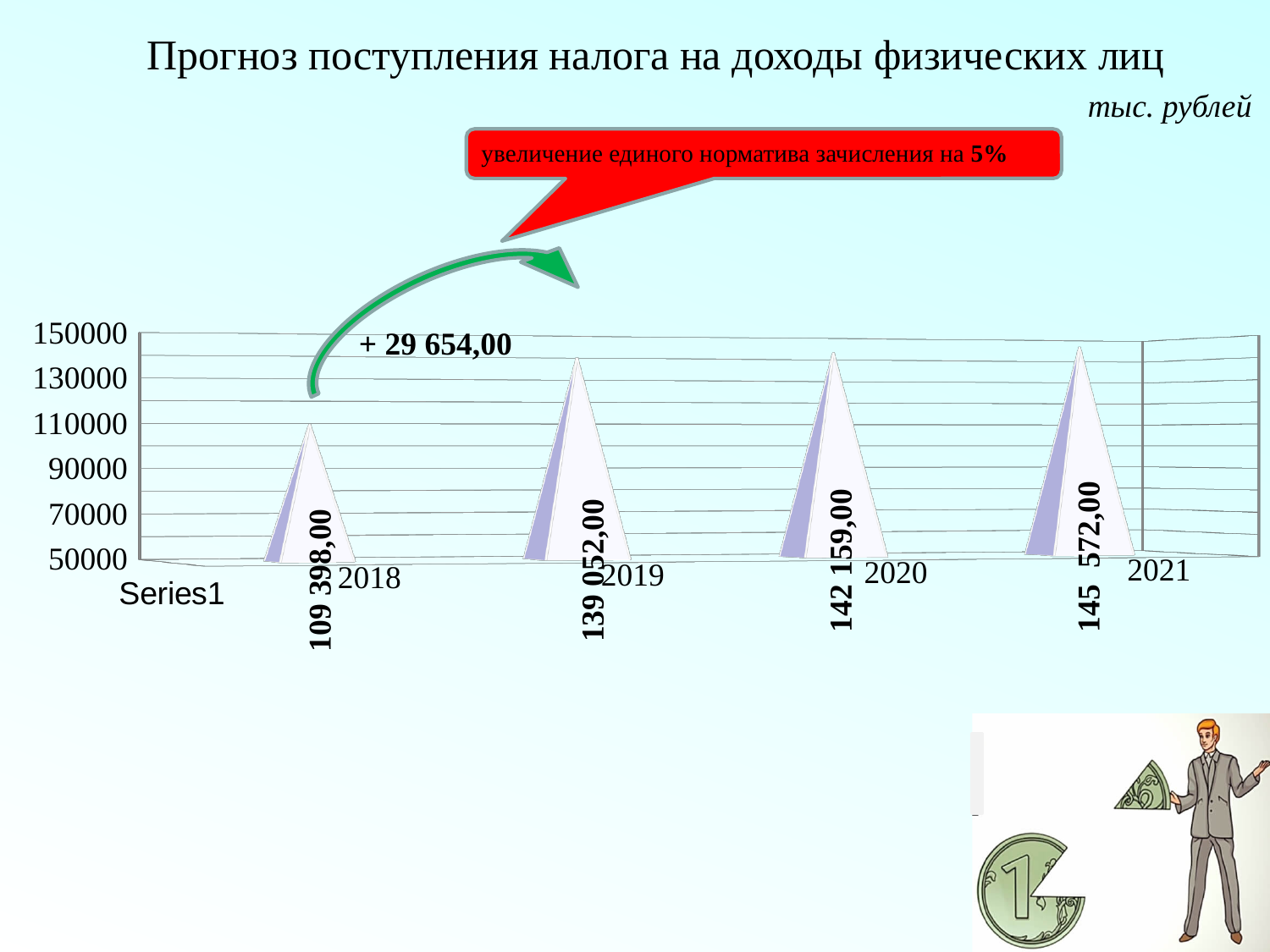
What is the value for 2019? 139 052,00 Do the values rise or fall from 2018 to 2021? rise Which year has the highest value? 2021 What is the difference between the values for 2021 and 2020? 3 413,00 What is the difference between the values for 2019 and 2018? 29 654,00 Which is larger, the value for 2019 or the value for 2020? 2020 What is the value for 2021? 145 572,00 Which year has the lowest value? 2018 Is the value for 2018 greater or less than 90000? greater What is the value for 2018? 109 398,00 How many years are shown on the x axis? 4 What is the value for 2020? 142 159,00